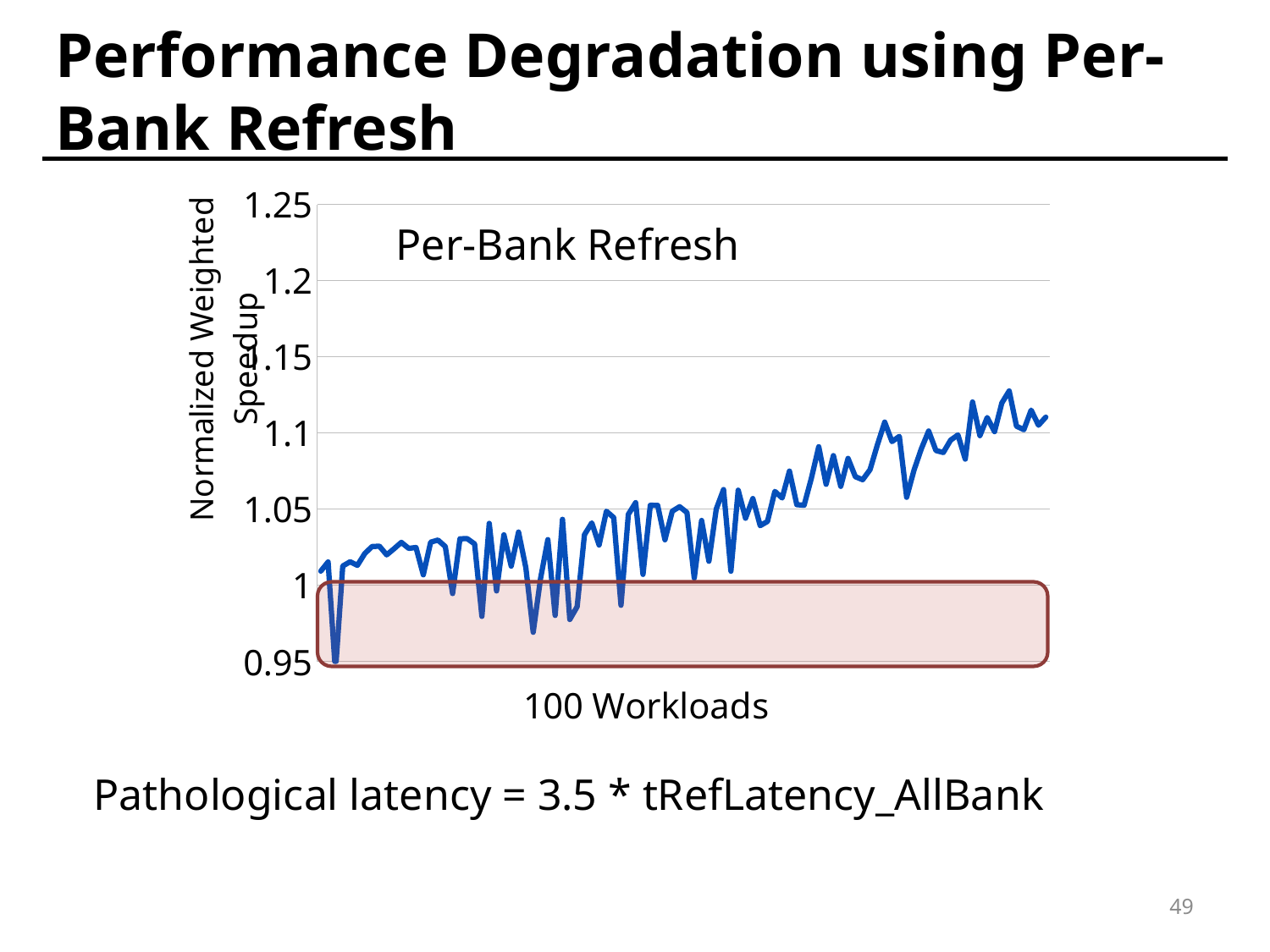
What is the label of the y axis? Normalized Weighted Speedup What kind of chart is shown on the slide? line chart Is the value for the last workload on the right greater or less than 1.05? greater How many lines are plotted on the chart? 1 Is the highest value on the line greater or less than 1.15? less What is the title of the chart? Per-Bank Refresh How many workloads are plotted along the x axis? 100 What is the highest tick value shown on the y axis? 1.25 Is the lowest value on the line greater or less than 1? less Do the values generally rise or fall from left to right along the x axis? rise